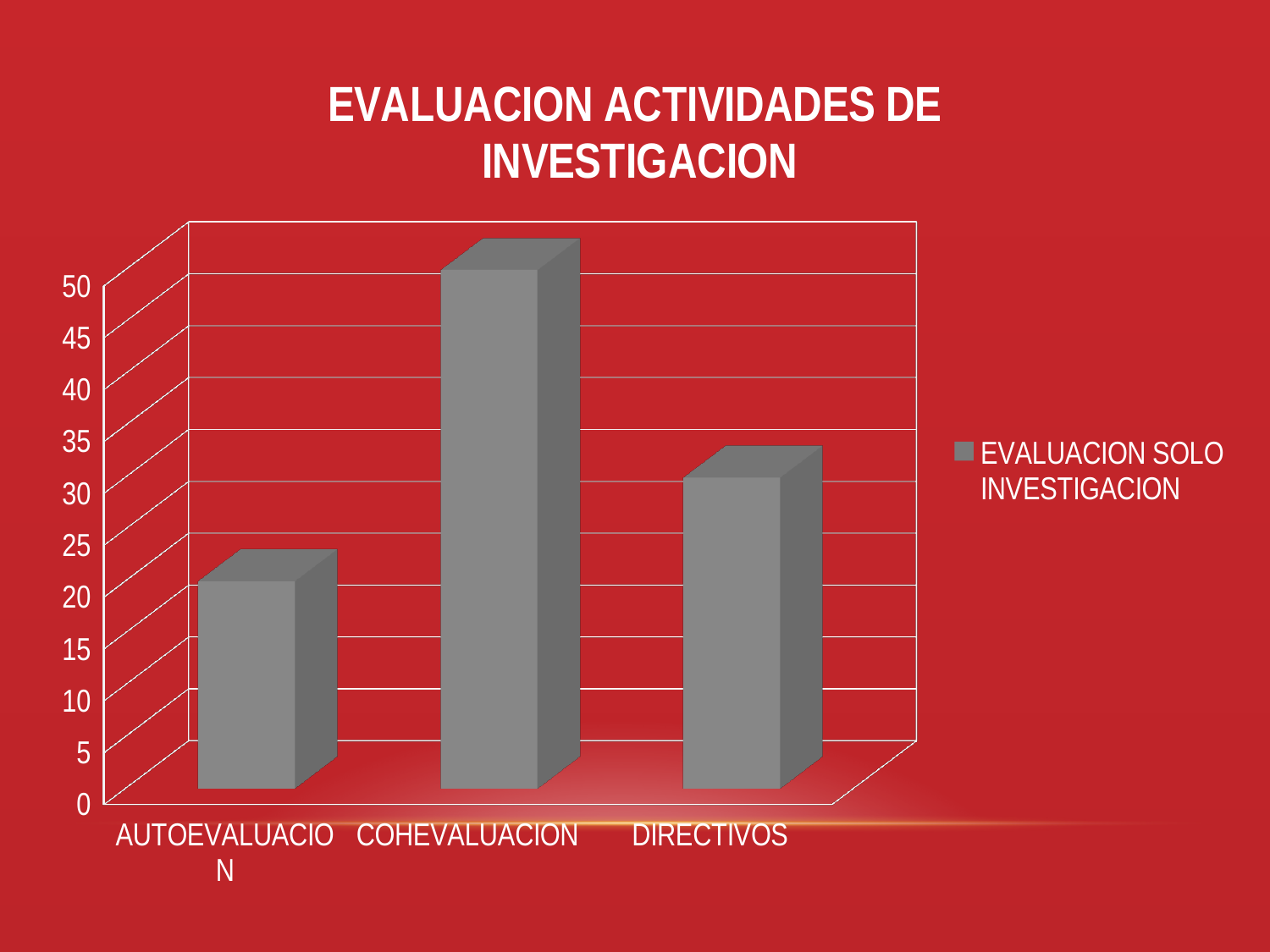
Is the value for AUTOEVALUACION greater or less than 25? less Does the value rise or fall from AUTOEVALUACION to COHEVALUACION? rise Is the value for COHEVALUACION greater or less than 45? greater Which category has the lowest bar? AUTOEVALUACION Which is larger, the value for DIRECTIVOS or the value for AUTOEVALUACION? DIRECTIVOS Which category has the highest bar? COHEVALUACION Is the value for DIRECTIVOS greater or less than 25? greater What type of chart is shown on the slide? Bar chart What is the name of the series shown in the legend? EVALUACION SOLO INVESTIGACION How many series does the legend list? 1 How many categories are shown on the x axis of the chart? 3 What is the title of the chart? EVALUACION ACTIVIDADES DE INVESTIGACION